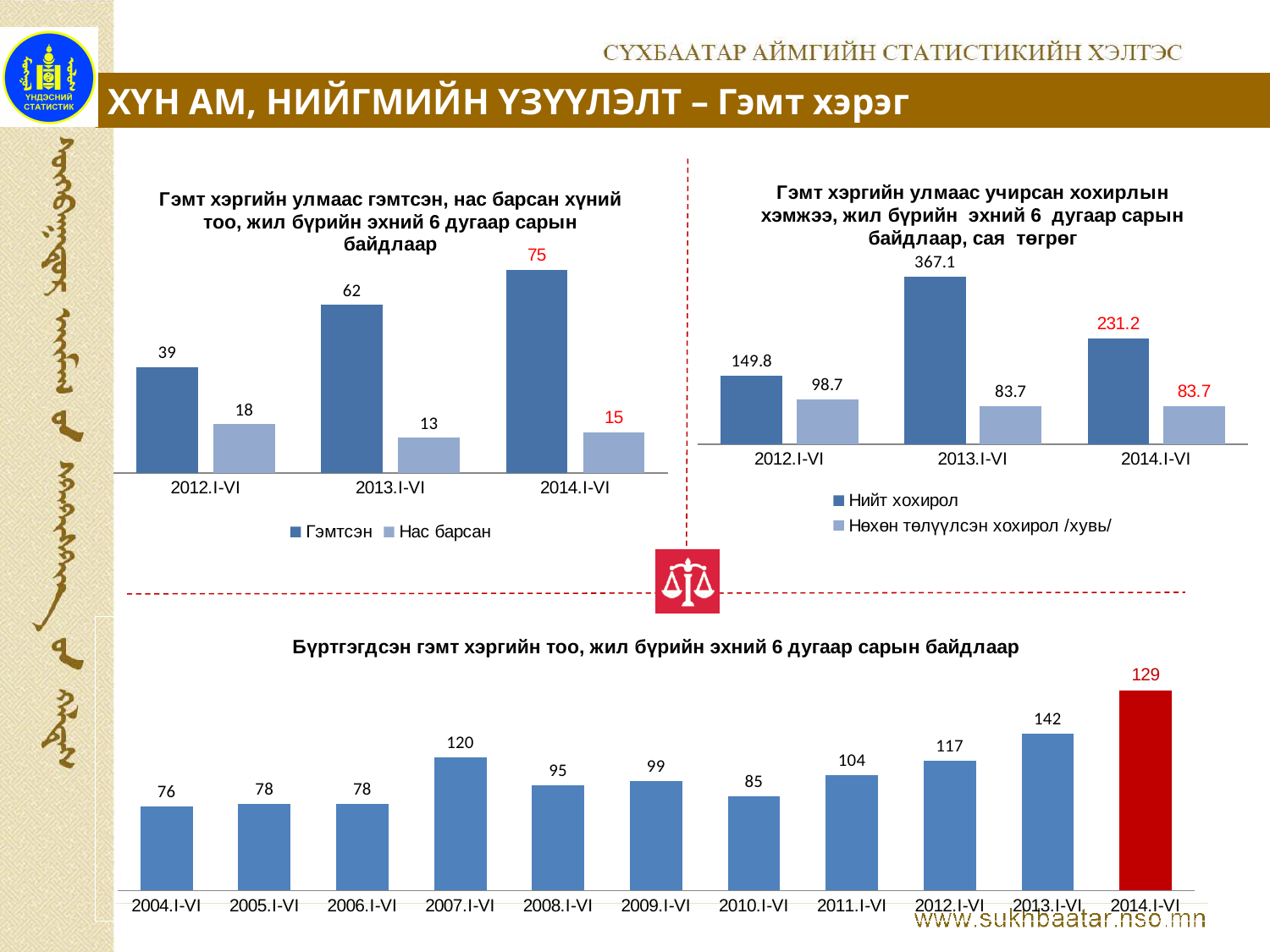
In the top-right chart (Гэмт хэргийн улмаас учирсан хохирлын хэмжээ), which period has the highest Нийт хохирол value? 2013.I-VI In the top-right chart (Гэмт хэргийн улмаас учирсан хохирлын хэмжээ), what is the difference between the Нийт хохирол values for 2013.I-VI and 2014.I-VI? 135.9 In the bottom chart (Бүртгэгдсэн гэмт хэргийн тоо), which period has the lowest value? 2004.I-VI In the top-left chart (Гэмт хэргийн улмаас гэмтсэн, нас барсан хүний тоо), does the Гэмтсэн series rise or fall from 2012.I-VI to 2014.I-VI? Rise In the bottom chart (Бүртгэгдсэн гэмт хэргийн тоо), how many periods are shown on the x axis? 11 In the top-left chart (Гэмт хэргийн улмаас гэмтсэн, нас барсан хүний тоо), how many series does the legend list? 2 In the bottom chart (Бүртгэгдсэн гэмт хэргийн тоо), what is the value for 2013.I-VI? 142 In the bottom chart (Бүртгэгдсэн гэмт хэргийн тоо), which is larger: the value for 2007.I-VI or 2011.I-VI? 2007.I-VI What kind of chart is the bottom chart (Бүртгэгдсэн гэмт хэргийн тоо)? Bar chart In the top-right chart (Гэмт хэргийн улмаас учирсан хохирлын хэмжээ), what is the Нийт хохирол value for 2013.I-VI? 367.1 In the top-left chart (Гэмт хэргийн улмаас гэмтсэн, нас барсан хүний тоо), what is the Гэмтсэн value for 2013.I-VI? 62